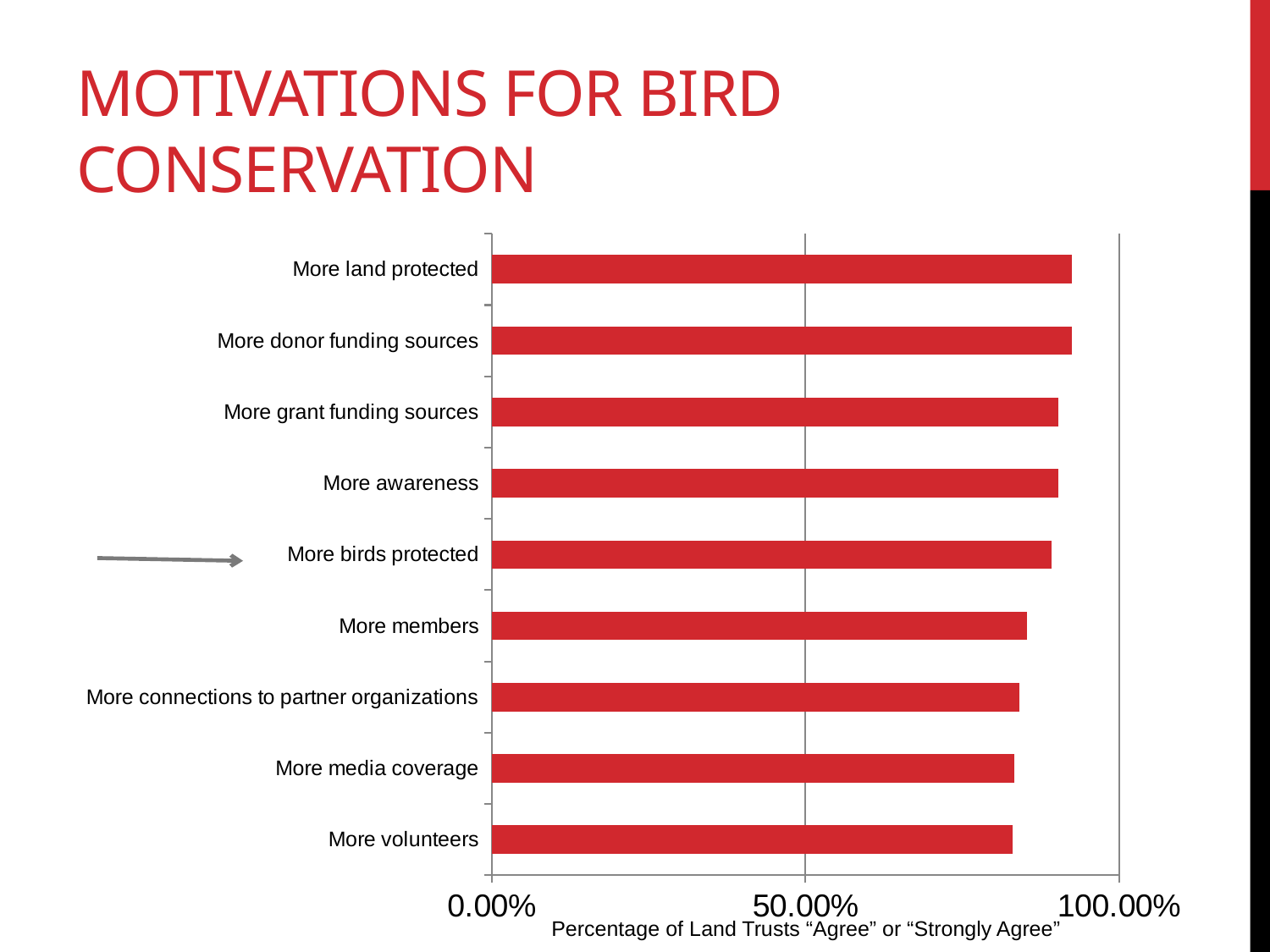
Is the value for More media coverage greater or less than 100.00%? less Is the value for More volunteers greater or less than 50.00%? greater Which has the larger value, More donor funding sources or More media coverage? More donor funding sources Which has the larger value, More birds protected or More members? More birds protected What kind of chart is shown on the slide? bar chart What is the label of the horizontal axis? Percentage of Land Trusts "Agree" or "Strongly Agree" Is the value for More land protected greater or less than 50.00%? greater What colour are the bars in the chart? red Which has the larger value, More awareness or More connections to partner organizations? More awareness How many categories (motivations) are plotted in the chart? 9